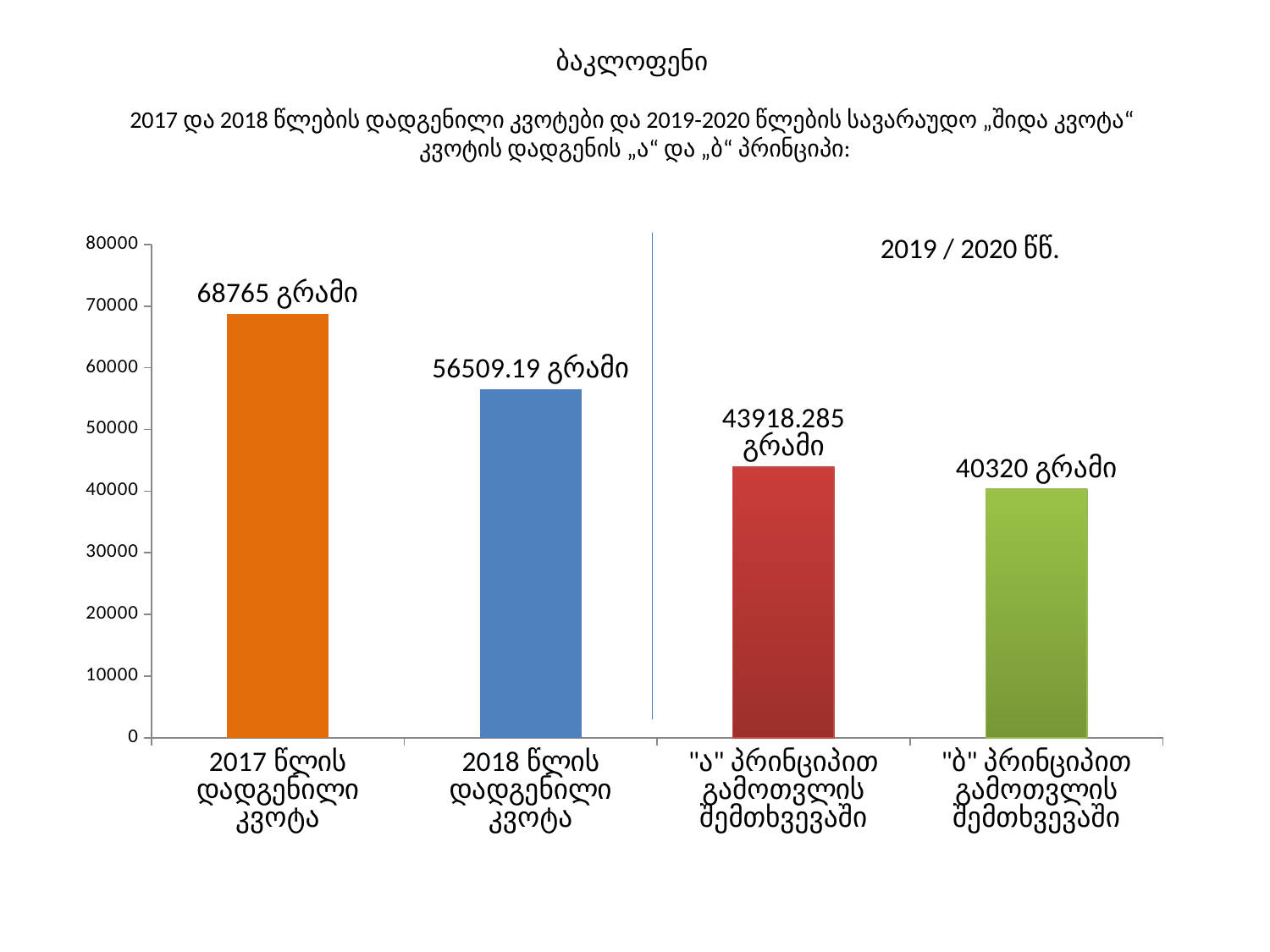
Which category has the lowest value? "ბ" პრინციპით გამოთვლის შემთხვევაში How many bars are shown in the chart? 4 What is the value for the "ა" პრინციპით გამოთვლის შემთხვევაში bar? 43918.285 გრამი Which category has the highest value? 2017 წლის დადგენილი კვოტა What is the value for the 2018 წლის დადგენილი კვოტა bar? 56509.19 გრამი What is the difference between the 2017 წლის დადგენილი კვოტა and the 2018 წლის დადგენილი კვოტა values? 12255.81 გრამი Which is larger: the value for "ა" პრინციპით გამოთვლის შემთხვევაში or for "ბ" პრინციპით გამოთვლის შემთხვევაში? "ა" პრინციპით გამოთვლის შემთხვევაში What kind of chart is shown on the slide? bar chart Do the values rise or fall from left to right along the x axis? fall What is the value for the 2017 წლის დადგენილი კვოტა bar? 68765 გრამი Is the value for 2018 წლის დადგენილი კვოტა greater or less than 60000? less What is the value for the "ბ" პრინციპით გამოთვლის შემთხვევაში bar? 40320 გრამი